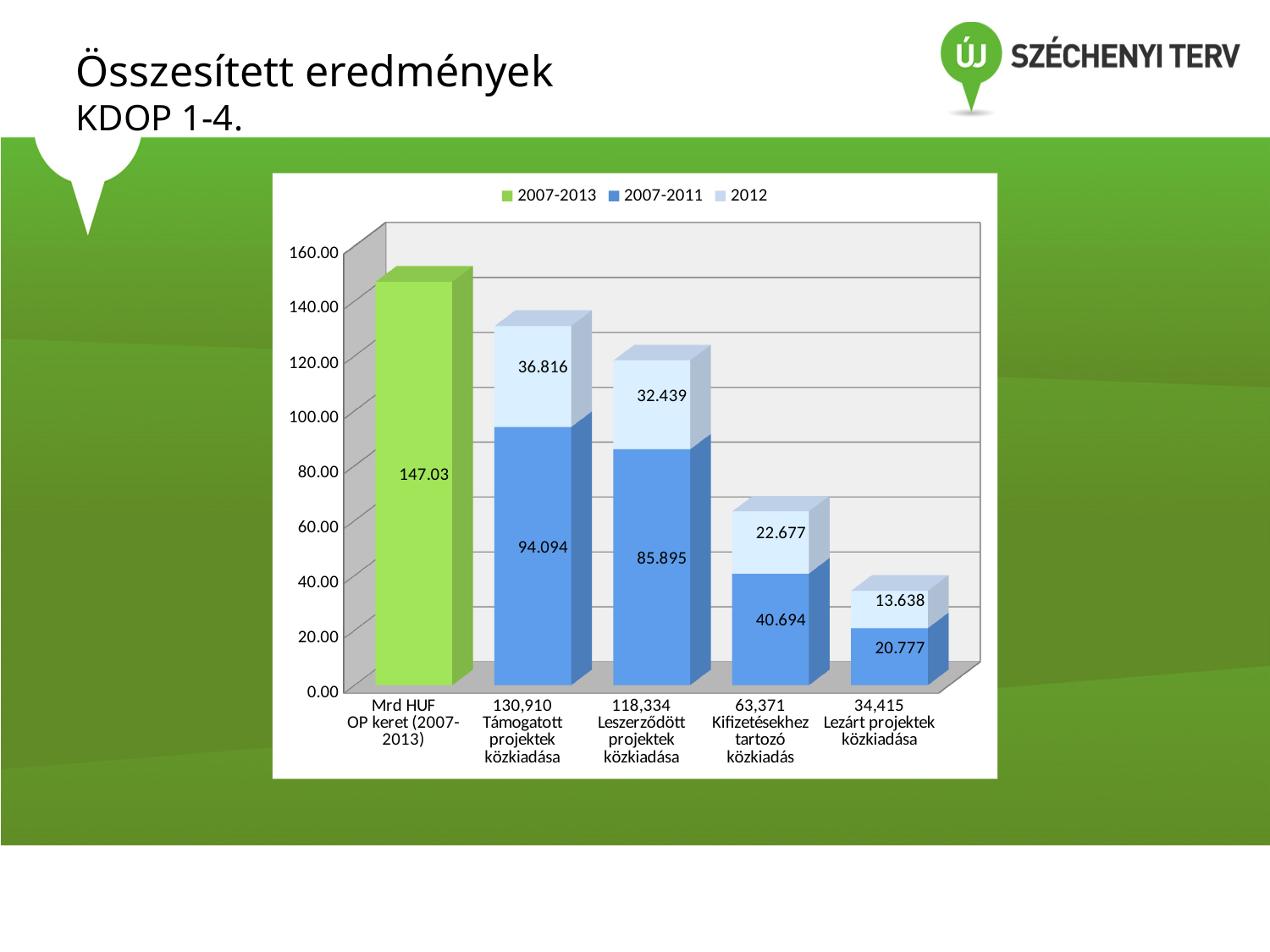
What is the 2012 value for 'Leszerződött projektek közkiadása'? 32.439 What kind of chart is shown on the slide? stacked bar chart Which category has the highest 2012 value? Támogatott projektek közkiadása What is the 2007-2011 value for 'Támogatott projektek közkiadása'? 94.094 Which category has the lowest 2007-2011 value? Lezárt projektek közkiadása What is the value of the 2007-2013 series for 'Mrd HUF OP keret (2007-2013)'? 147.03 Which is larger: the 2012 value for 'Kifizetésekhez tartozó közkiadás' or the 2012 value for 'Lezárt projektek közkiadása'? Kifizetésekhez tartozó közkiadás What is the 2007-2011 value for 'Lezárt projektek közkiadása'? 20.777 How many series does the legend list? 3 What is the 2012 value for 'Kifizetésekhez tartozó közkiadás'? 22.677 What is the difference between the 2007-2011 values for 'Támogatott projektek közkiadása' and 'Leszerződött projektek közkiadása'? 8.199 What is the total of the stacked bar for 'Kifizetésekhez tartozó közkiadás'? 63.371